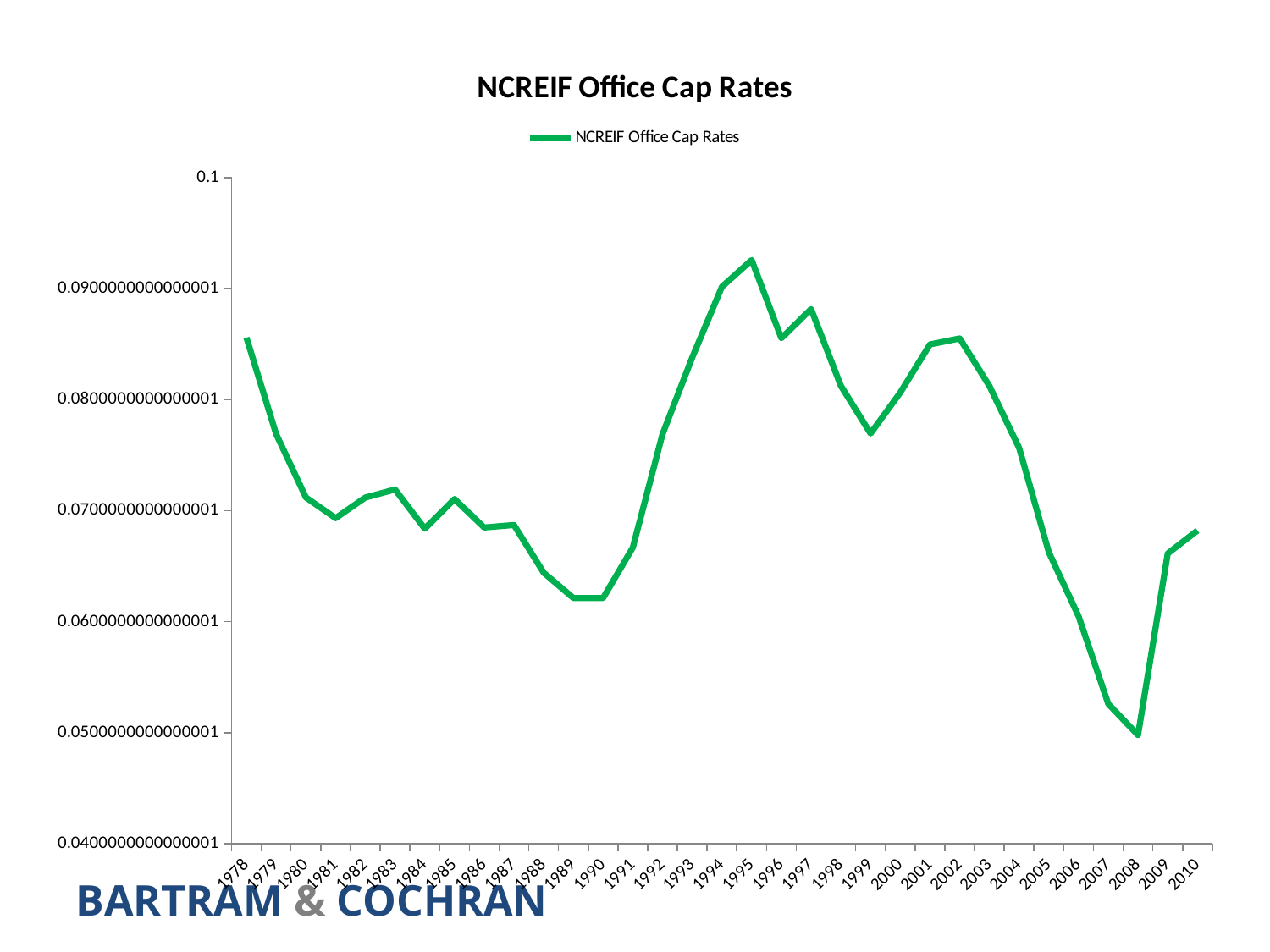
Which year has the higher cap rate, 1978 or 1990? 1978 How many series does the legend list? 1 Do the values rise or fall from 2005 to 2008? fall In which year is the NCREIF Office Cap Rate highest? 1995 How many years are plotted along the x axis? 33 Is the value for 1999 greater or less than 0.08? less What is the title of the chart? NCREIF Office Cap Rates Is the value for 1995 greater or less than 0.09? greater Is the value for 1978 greater or less than 0.08? greater In which year is the NCREIF Office Cap Rate lowest? 2008 What kind of chart is shown on the slide? line chart